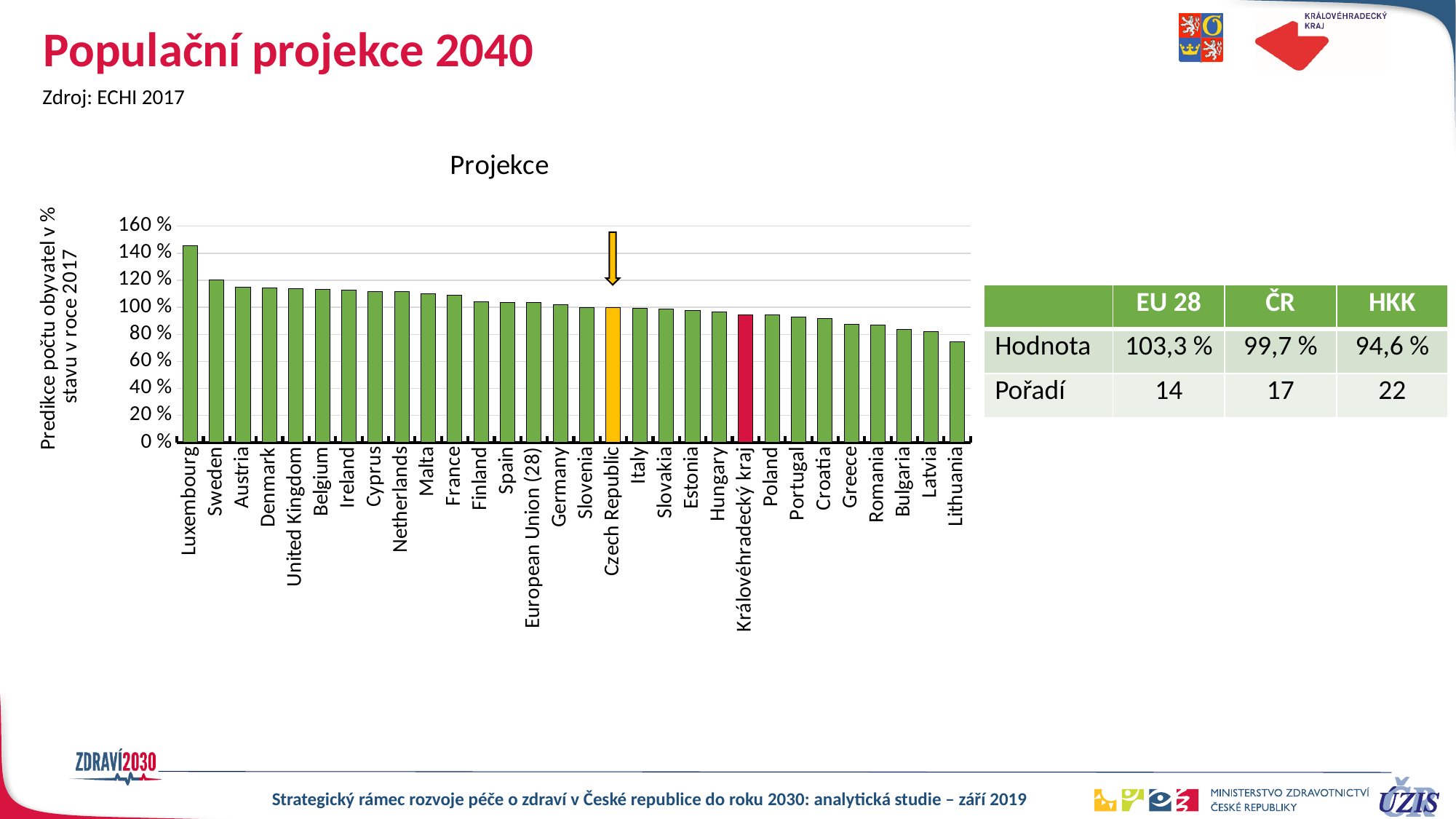
Which category has the lowest value in the chart? Lithuania What kind of chart is shown on the slide? bar chart Which category has the highest value in the chart? Luxembourg Do the values rise or fall from left to right along the x axis? fall How many categories (bars) are plotted in the chart? 30 What is the title of the chart? Projekce Is the value for Lithuania greater or less than 80 %? less Is the value for Luxembourg greater or less than 120 %? greater What is the value for Královéhradecký kraj (HKK) according to the slide? 94,6 % What is the value for the Czech Republic (ČR) according to the slide? 99,7 % What is the value for European Union (28) according to the slide? 103,3 % What is the difference between the EU 28 value and the ČR value? 3,6 %